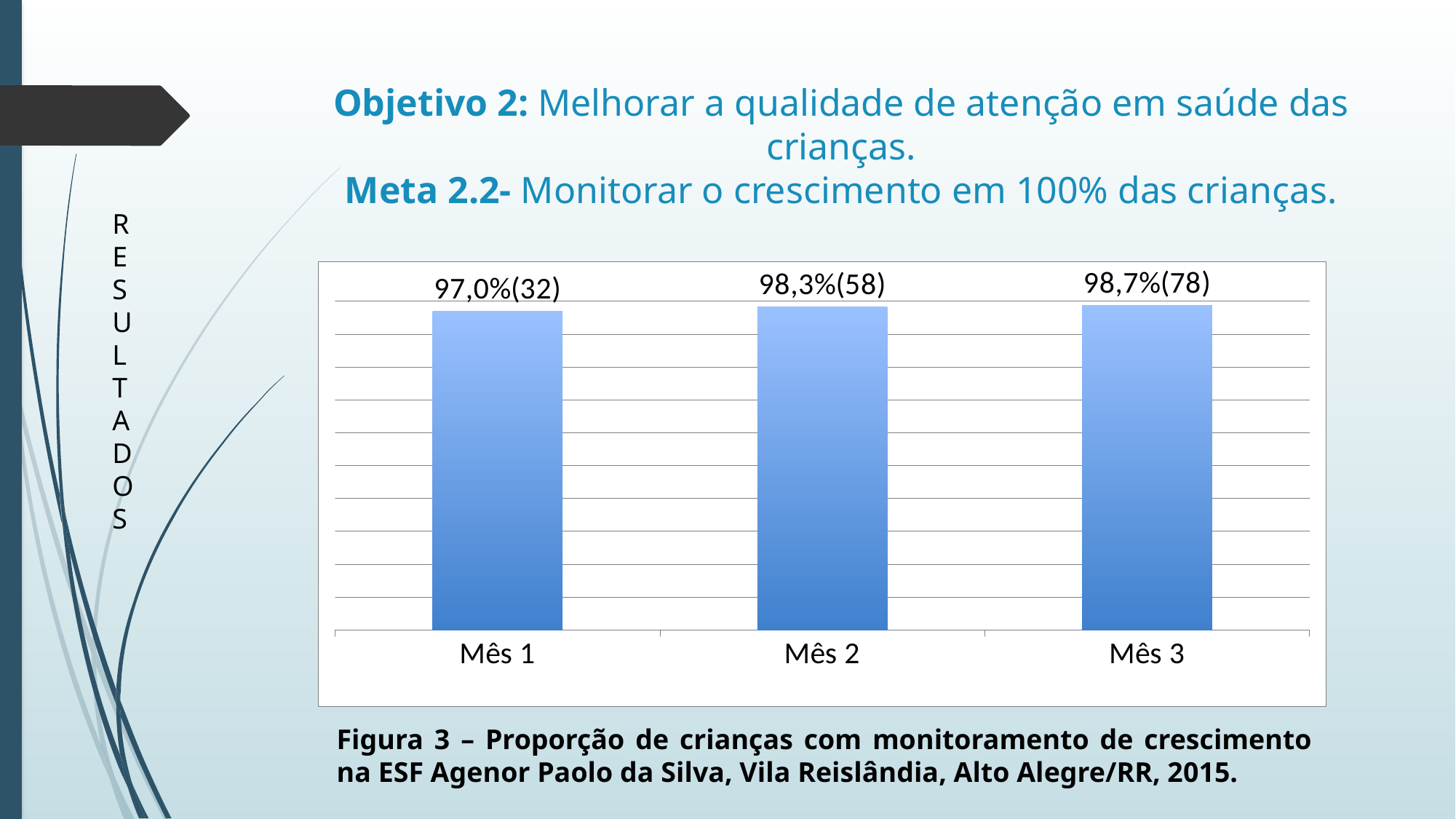
What is the difference in percentage points between Mês 3 and Mês 1? 1,7 Which month has the highest percentage? Mês 3 What is the value shown for Mês 3? 98,7%(78) What kind of chart is shown on the slide? Bar chart What percentage is shown for Mês 2? 98,3% How many months (categories) are shown in the chart? 3 What is the value shown for Mês 1? 97,0%(32) Do the percentages rise or fall from Mês 1 to Mês 3? Rise How many children are shown in parentheses for Mês 2? 58 How many more children are counted in Mês 3 than in Mês 1? 46 Which month has the lowest percentage? Mês 1 Which is larger, the percentage for Mês 1 or for Mês 2? Mês 2